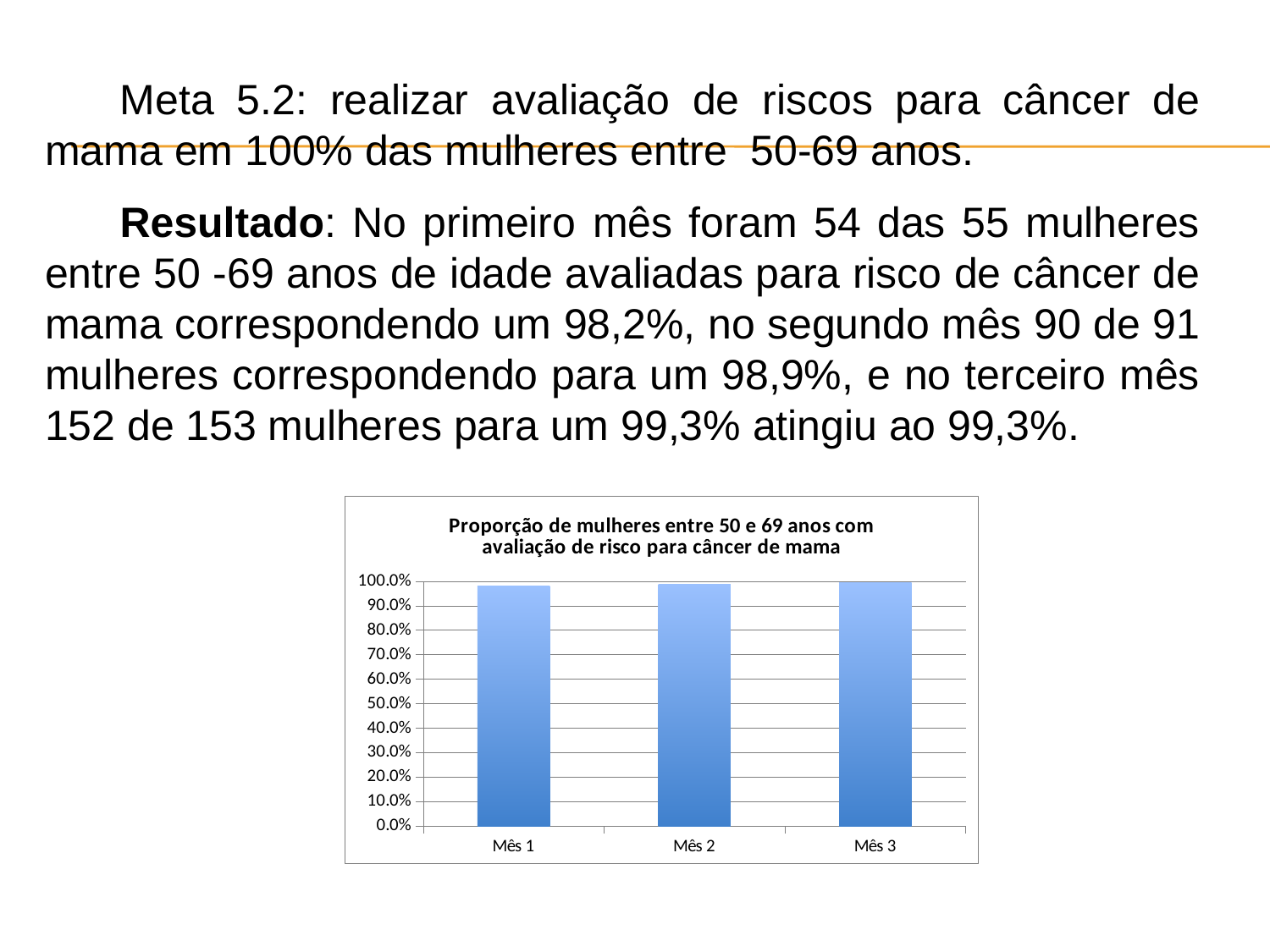
What is the highest tick value shown on the y axis of the chart? 100.0% Is the value for Mês 1 greater or less than 90.0%? greater Is the value for Mês 3 greater or less than 80.0%? greater Is the value for Mês 1 greater or less than 100.0%? less What is the title of the chart? Proporção de mulheres entre 50 e 69 anos com avaliação de risco para câncer de mama How many categories (bars) does the chart show? 3 What kind of chart is shown on the slide? bar chart What are the category labels on the x axis of the chart? Mês 1, Mês 2, Mês 3